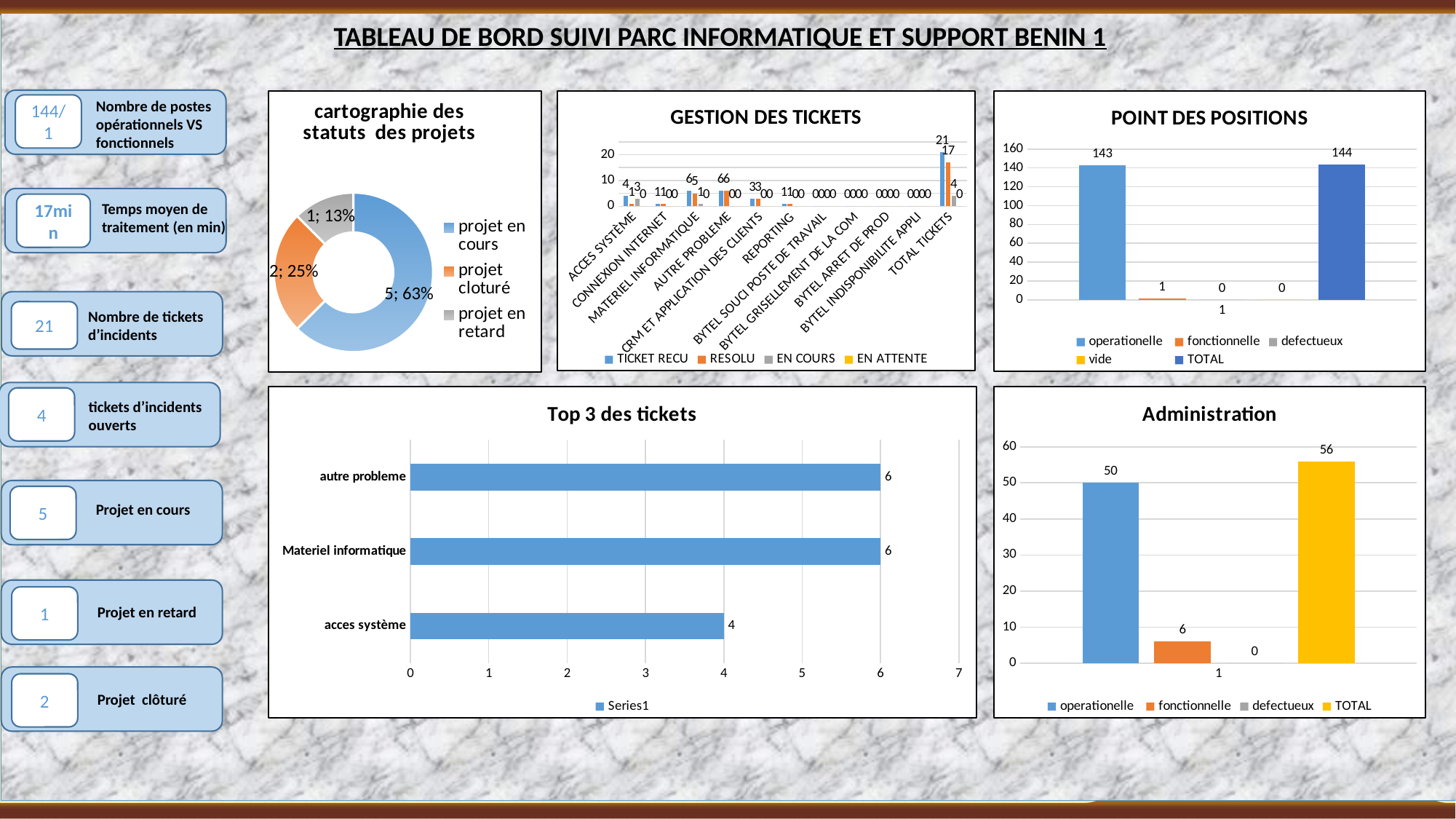
In the 'POINT DES POSITIONS' chart, what is the value for 'operationelle'? 143 In the 'cartographie des statuts des projets' chart, what share of the projects is 'projet en cours'? 63% In the 'GESTION DES TICKETS' chart, what is the 'TICKET RECU' value for 'TOTAL TICKETS'? 21 In the 'Top 3 des tickets' chart, what is the value for 'acces système'? 4 In the 'Top 3 des tickets' chart, what is the difference between 'autre probleme' and 'acces système'? 2 In the 'Administration' chart, what is the difference between 'TOTAL' and 'operationelle'? 6 In the 'cartographie des statuts des projets' chart, which status has the smallest slice? projet en retard In the 'POINT DES POSITIONS' chart, how many series does the legend list? 5 In the 'Administration' chart, which is larger, 'operationelle' or 'fonctionnelle'? operationelle What kind of chart is 'Top 3 des tickets'? bar chart In the 'cartographie des statuts des projets' chart, how many projects are 'projet cloturé'? 2 In the 'Administration' chart, what is the value for 'TOTAL'? 56